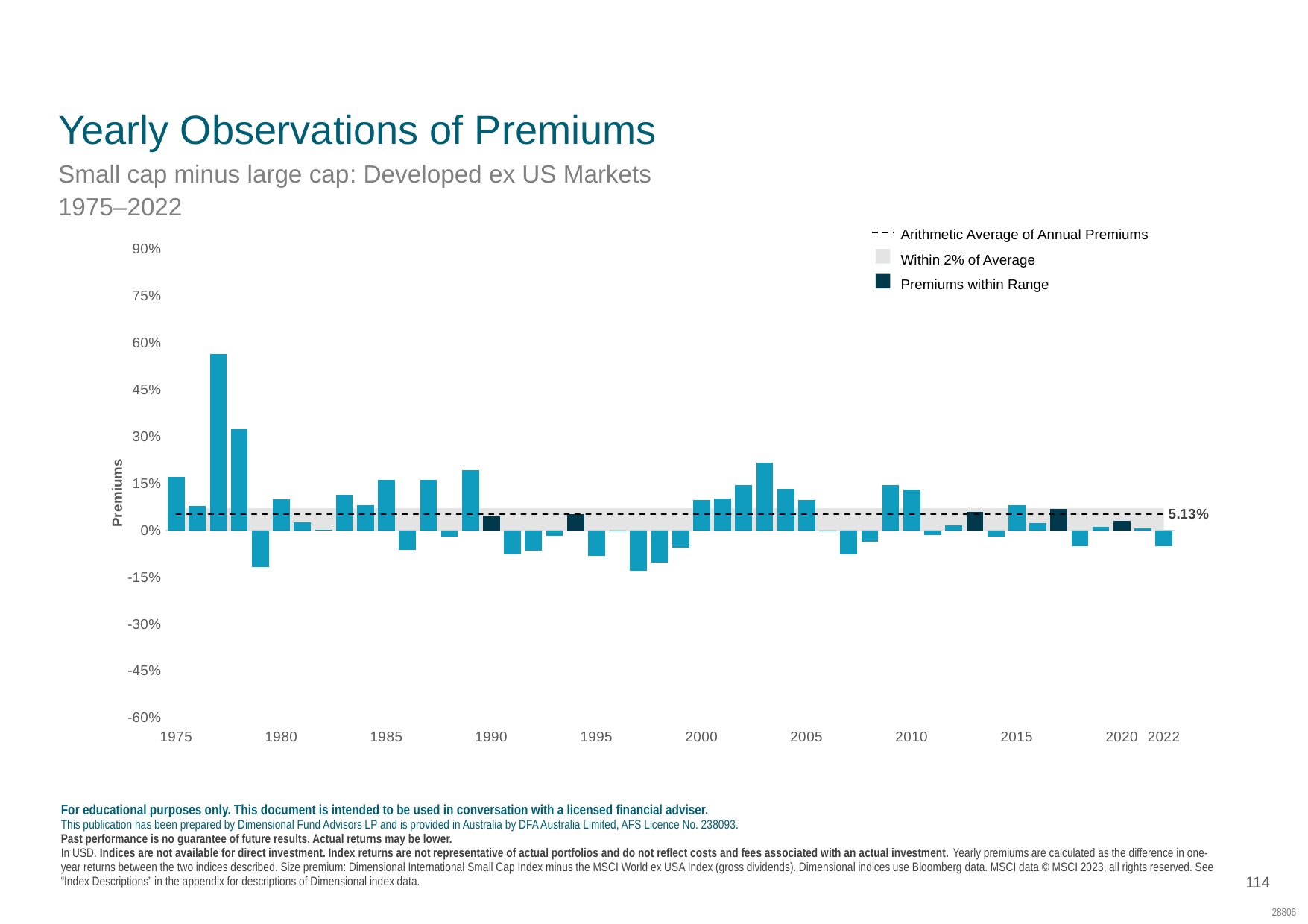
How many entries does the legend list? 3 Is the premium for 1977 greater or less than 45%? greater Is the premium for 1979 greater or less than 0%? less Is the premium for 2003 greater or less than 15%? greater Which year has the larger premium, 1977 or 1978? 1977 What is the title of the chart on the slide? Yearly Observations of Premiums How many yearly bars are plotted on the chart (1975 through 2022)? 48 What is the arithmetic average of annual premiums shown on the chart? 5.13% Which year has the highest premium on the chart? 1977 What is the label on the vertical axis of the chart? Premiums Which year has the larger premium, 2003 or 2005? 2003 What kind of chart is shown on the slide? bar chart